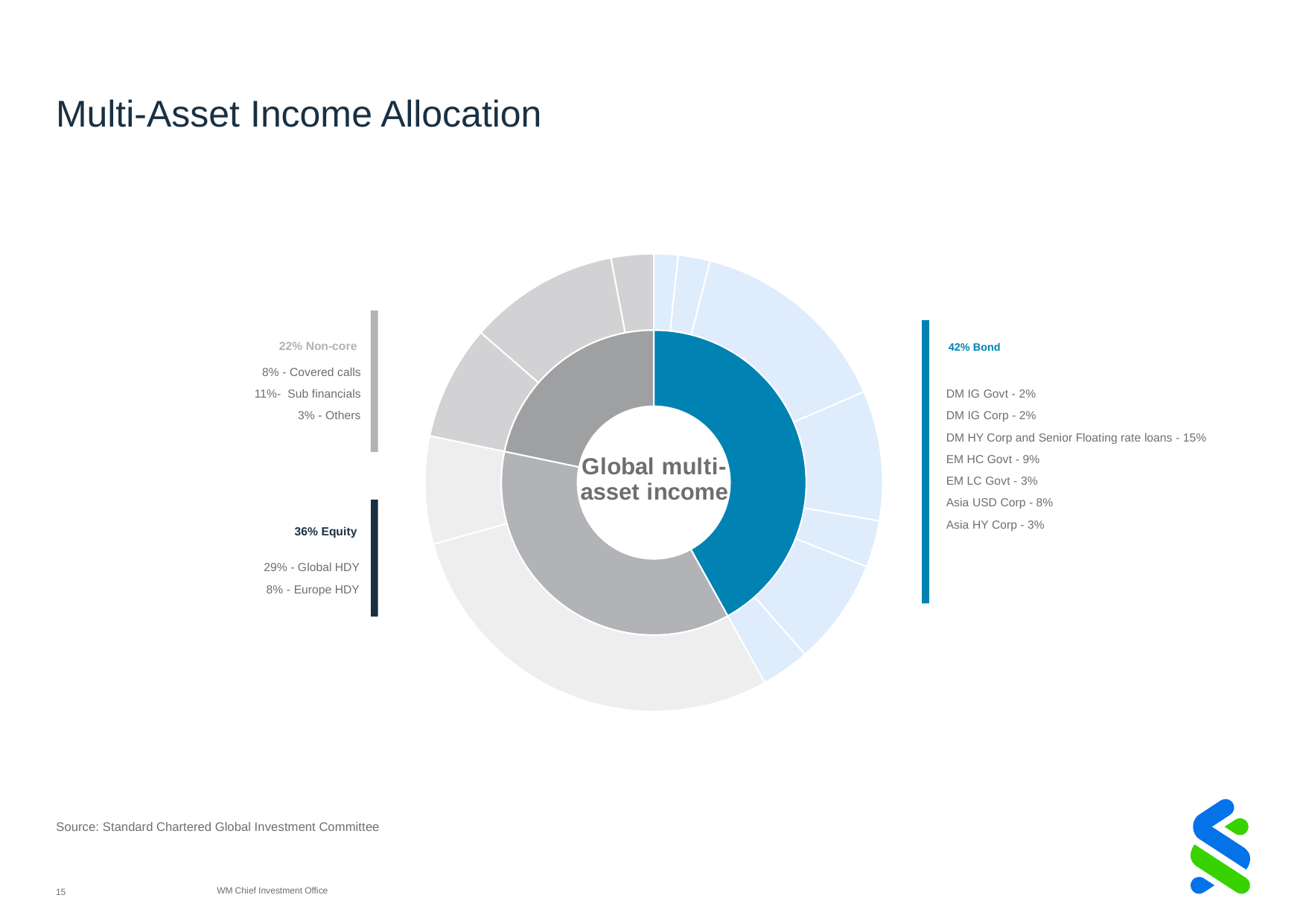
What is the difference between the Bond share and the Equity share? 6% How many sub-categories are listed under Bond? 7 What share of the allocation is Equity? 36% Which of the three main asset groups has the smallest share? Non-core What share of the allocation is Bond? 42% What share of the allocation is Non-core? 22% Which of the three main asset groups has the largest share? Bond What is the allocation to Global HDY? 29% What kind of chart is shown on the slide? Donut chart What text appears in the centre of the donut chart? Global multi-asset income What is the allocation to DM HY Corp and Senior Floating rate loans? 15% Which is larger, the allocation to Sub financials or to Covered calls? Sub financials